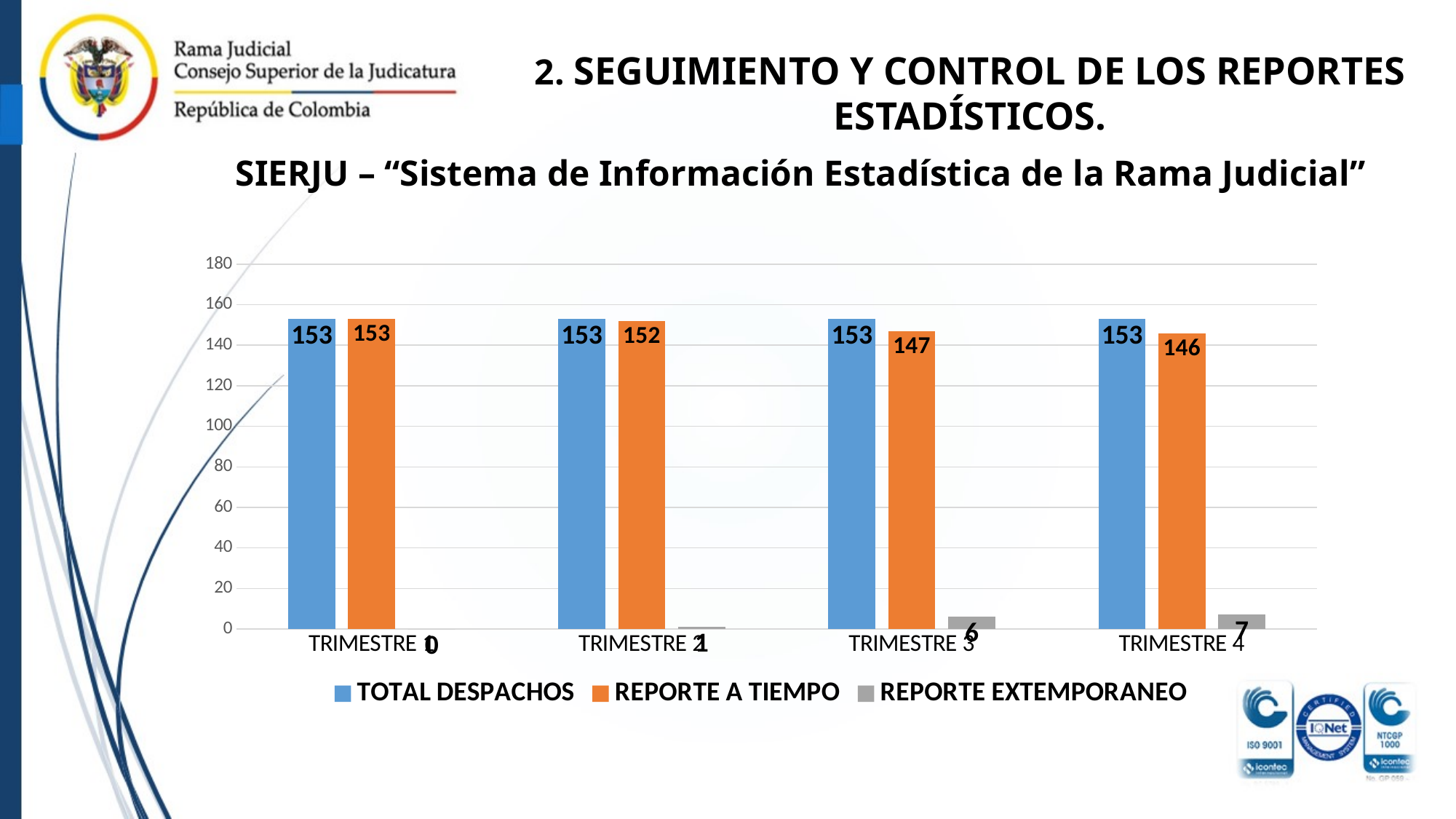
Does the REPORTE A TIEMPO value rise or fall from TRIMESTRE 1 to TRIMESTRE 4? fall What is the value of REPORTE A TIEMPO for TRIMESTRE 4? 146 Which series is shown in orange in the legend? REPORTE A TIEMPO What is the value of TOTAL DESPACHOS for TRIMESTRE 2? 153 Which trimestre has the lowest value for REPORTE A TIEMPO? TRIMESTRE 4 What is the value of REPORTE A TIEMPO for TRIMESTRE 3? 147 What is the value of REPORTE EXTEMPORANEO for TRIMESTRE 4? 7 What is the difference between TOTAL DESPACHOS and REPORTE A TIEMPO for TRIMESTRE 3? 6 What kind of chart is shown on the slide? bar chart What is the value of REPORTE EXTEMPORANEO for TRIMESTRE 3? 6 How many series does the legend list? 3 How many categories (trimestres) are shown on the x axis? 4